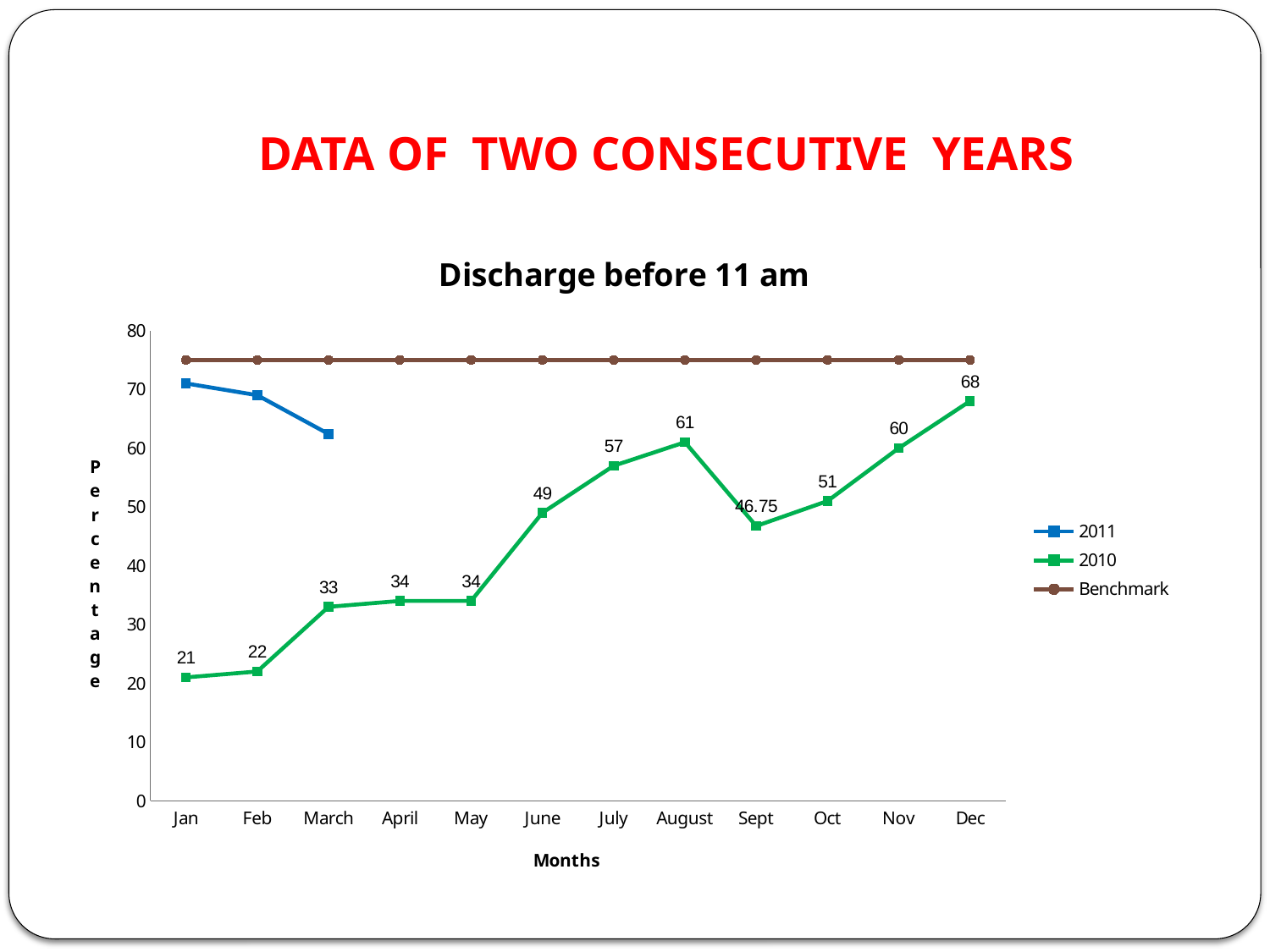
Is the Benchmark value greater or less than 70? greater Does the 2011 series rise or fall from Jan to March? fall How many series does the legend list? 3 What is the value for the 2010 series in August? 61 Which is larger for the 2010 series, the value for July or the value for Oct? July Which month has the highest value for the 2010 series? Dec Is the 2011 value for Jan greater or less than 60? greater What is the value for the 2010 series in Sept? 46.75 What kind of chart is shown on the slide? line chart Which month has the lowest value for the 2010 series? Jan How many months are shown on the x axis? 12 What is the difference between the 2010 values for Dec and Jan? 47